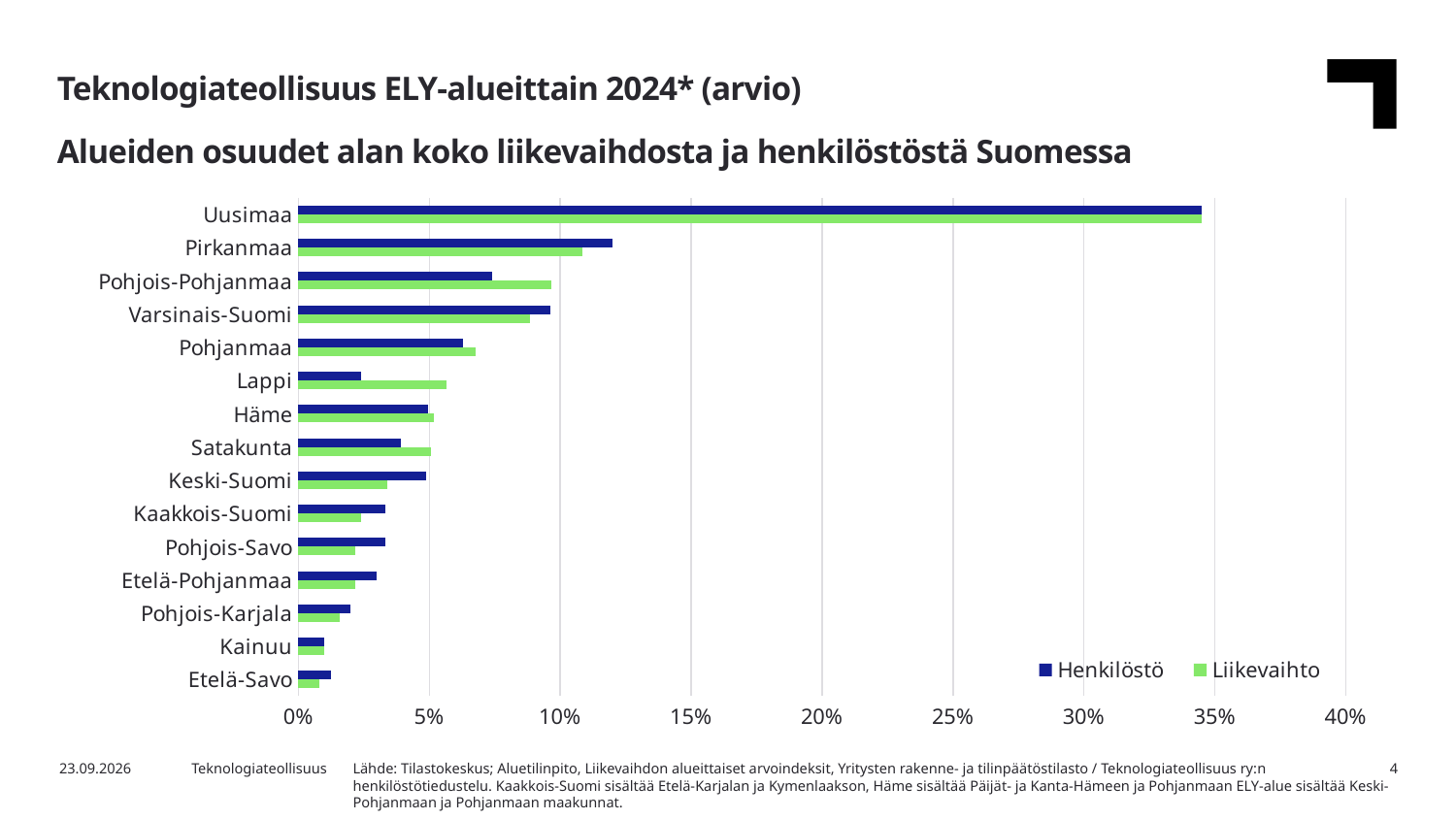
How many series does the legend list? 2 Which region has the highest Liikevaihto share? Uusimaa Is the Henkilöstö value for Pirkanmaa greater or less than 10%? greater For Lappi, which is larger: Henkilöstö or Liikevaihto? Liikevaihto How many regions (categories) are shown on the chart? 15 Which region has the highest Henkilöstö share? Uusimaa For Keski-Suomi, which is larger: Henkilöstö or Liikevaihto? Henkilöstö Is the Liikevaihto value for Pohjois-Pohjanmaa greater or less than 5%? greater Is the Henkilöstö value for Lappi greater or less than 5%? less What are the two series named in the legend? Henkilöstö and Liikevaihto What kind of chart is shown on the slide? Bar chart